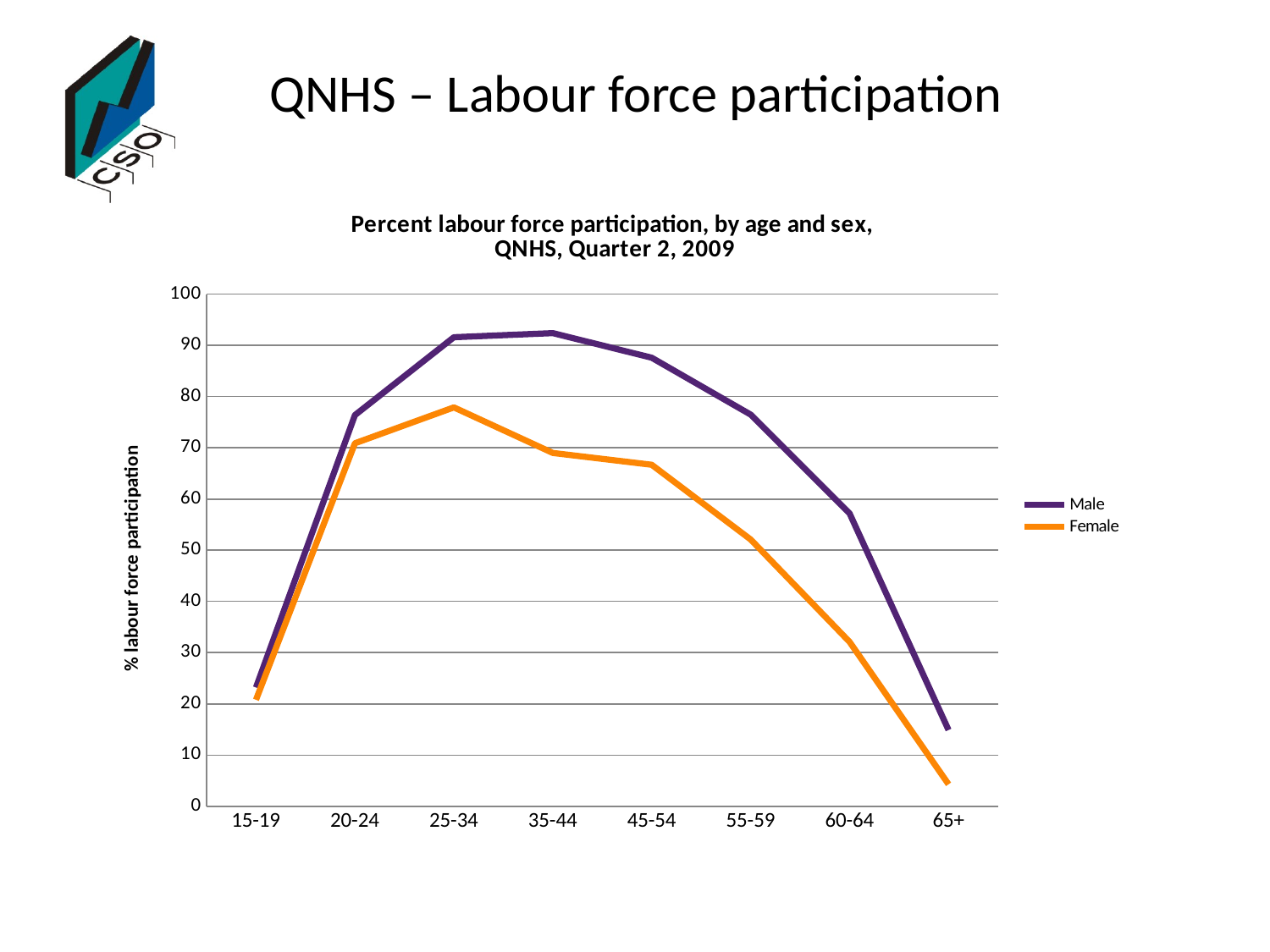
Is the Female value for 65+ greater or less than 10? less How many series does the legend list? 2 What kind of chart is shown on the slide? line chart Is the Male value for 20-24 greater or less than 70? greater How many age groups are shown on the x axis? 8 Is the Male value for 45-54 greater or less than 80? greater Does the Female line rise or fall from 25-34 to 65+? fall Which age group has the lowest Male labour force participation? 65+ What is the title of the chart? Percent labour force participation, by age and sex, QNHS, Quarter 2, 2009 Which is larger for the 60-64 age group, the Male or the Female value? Male Which age group has the highest Female labour force participation? 25-34